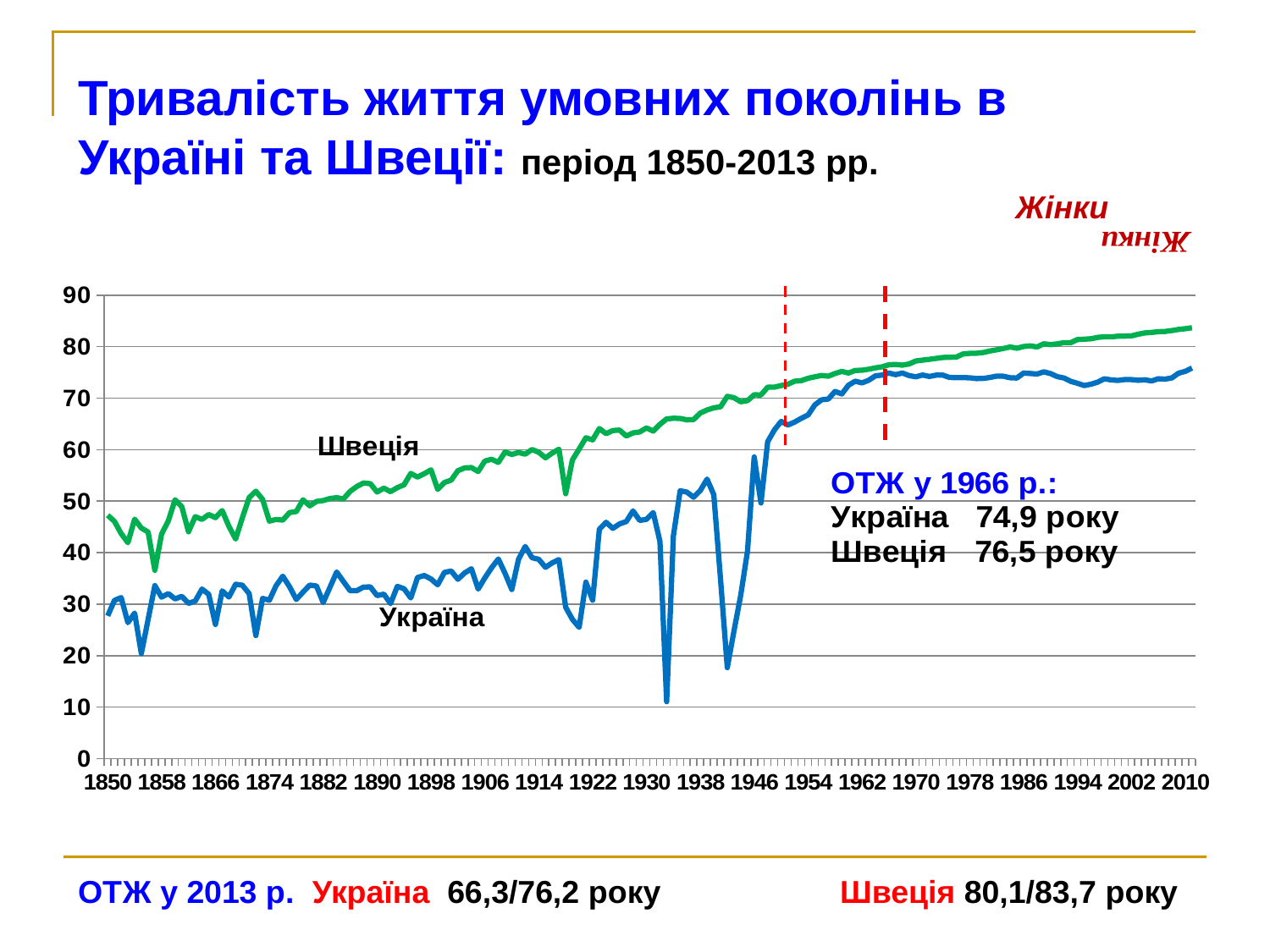
What kind of chart is shown on the slide? line chart Does the Швеція line generally rise or fall from 1850 to 2013? rise Is the lowest value of the Україна line (around 1933) greater or less than 20? less According to the annotation on the chart, what was the life expectancy (ОТЖ) in Швеція in 1966? 76,5 року Is the value for Швеція in 2010 greater or less than 80? greater Which country had the higher life expectancy in 1966 according to the annotation: Україна or Швеція? Швеція What colour is the line for Швеція? green Is the value for Україна in 1850 greater or less than 40? less Which line is higher around 1900: Швеція or Україна? Швеція How many countries (series) are plotted on the chart? 2 By how many years did Швеція exceed Україна in life expectancy in 1966, according to the annotation? 1,6 According to the annotation on the chart, what was the life expectancy (ОТЖ) in Україна in 1966? 74,9 року